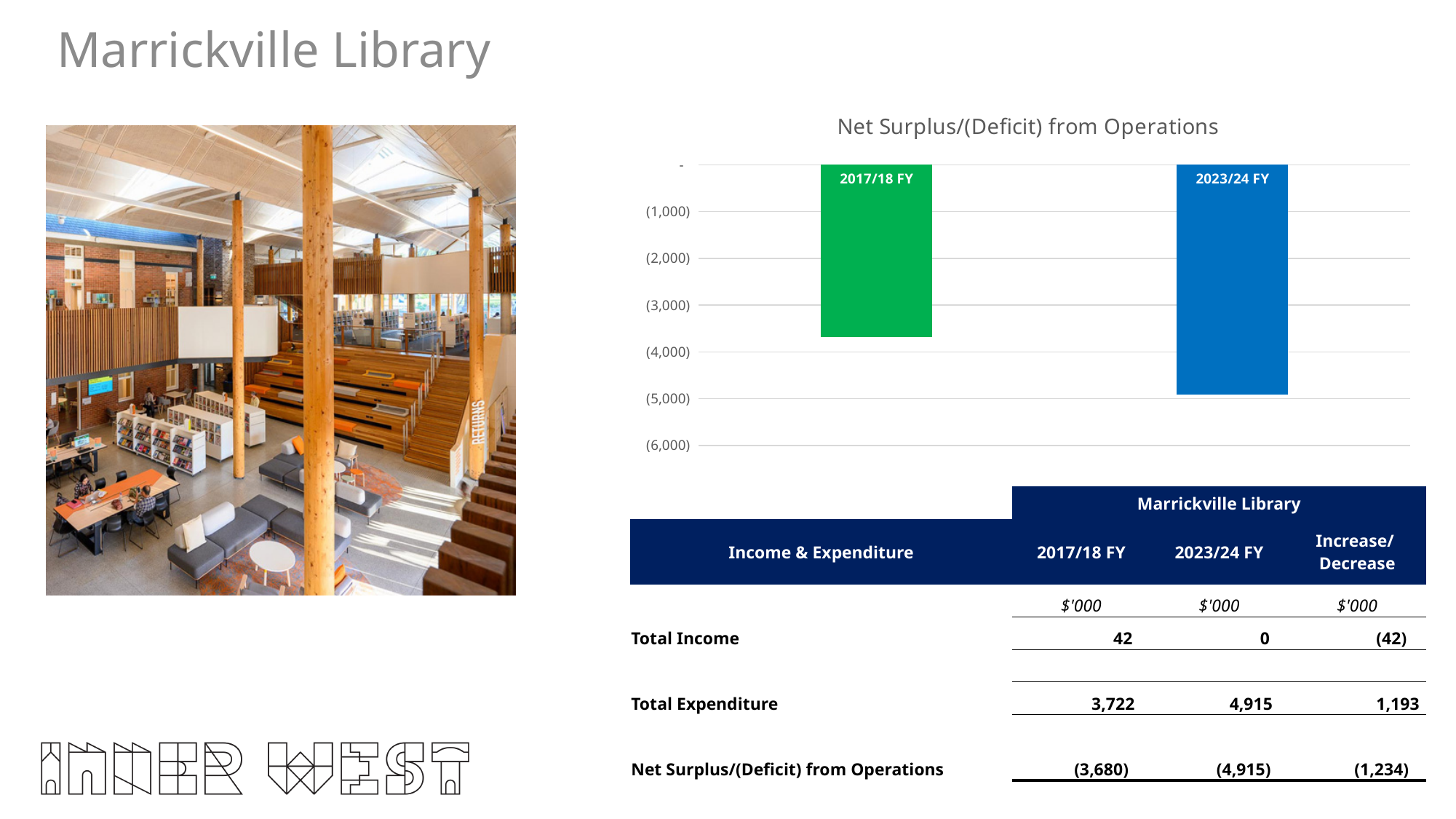
Which financial year shows the smaller deficit in the chart? 2017/18 FY What is the title of the chart? Net Surplus/(Deficit) from Operations What kind of chart is shown on the slide? bar chart Which financial year shows the larger deficit in the chart? 2023/24 FY Does the deficit from operations increase or decrease from 2017/18 FY to 2023/24 FY? increase Is the deficit shown for 2023/24 FY greater or less than 4,000? greater Is the deficit shown for 2017/18 FY greater or less than 3,000? greater How many bars (financial years) does the chart show? 2 By how much did the deficit from operations change between 2017/18 FY and 2023/24 FY? 1,234 What is the net surplus/(deficit) from operations for 2023/24 FY? (4,915) What colour is the bar for 2017/18 FY? green What is the net surplus/(deficit) from operations for 2017/18 FY? (3,680)